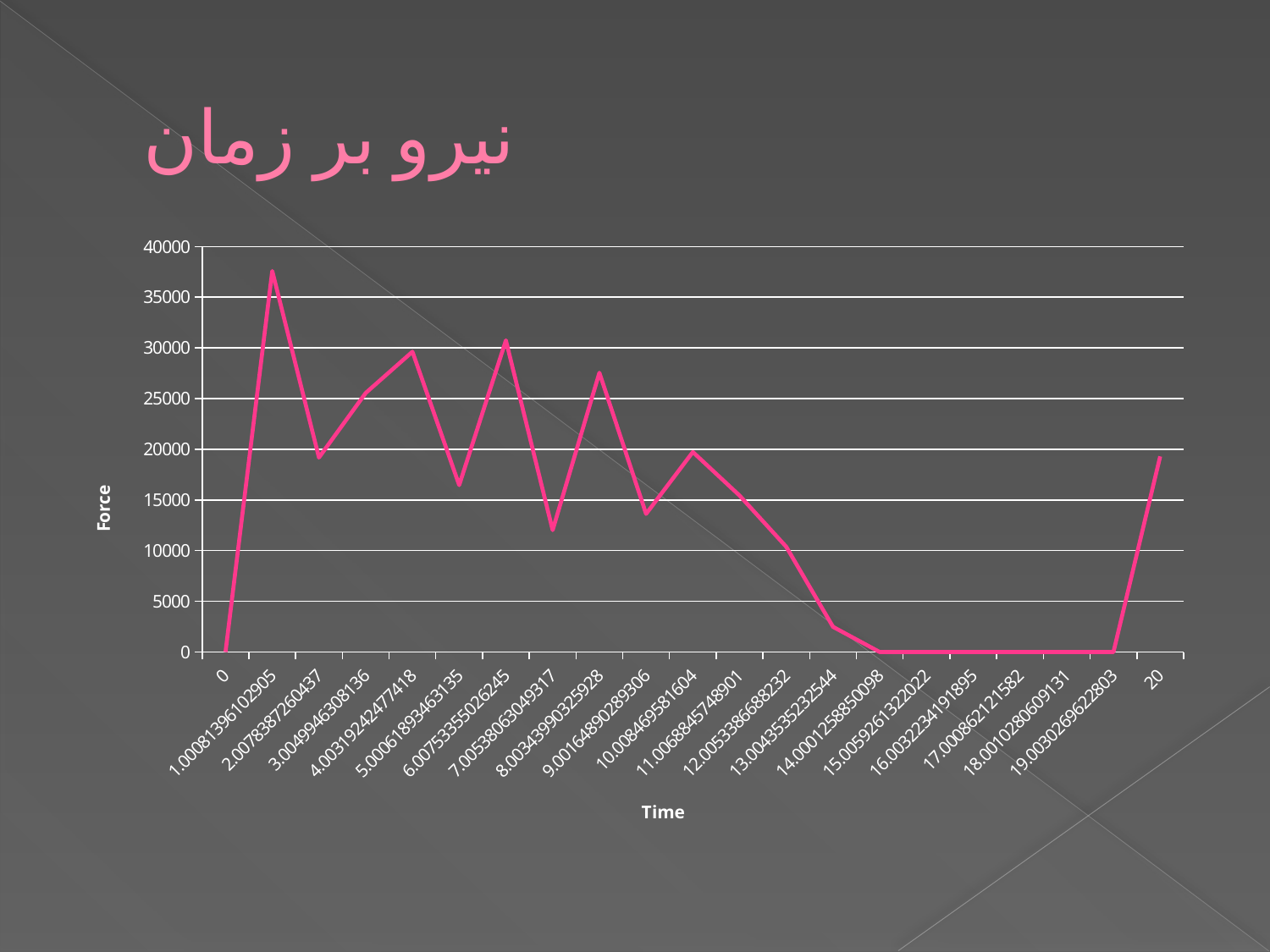
Which has the larger Force value: Time 2.0078387260437 or Time 4.00319242477418? 4.00319242477418 What is the Force value at Time 0? 0 At which Time value does the Force reach its highest point? 1.00081396102905 How many Time points are plotted on the x axis? 21 What is the lowest Force value plotted on the chart? 0 Is the Force value at Time 13.0043535232544 greater or less than 5000? less What kind of chart is shown on the slide? line chart What is the title of the chart? نیرو بر زمان What are the titles of the vertical and horizontal axes? Force and Time Is the Force value at Time 7.00538063049317 greater or less than 15000? less Is the Force value at Time 1.00081396102905 greater or less than 35000? greater What is the Force value at Time 17.000862121582? 0